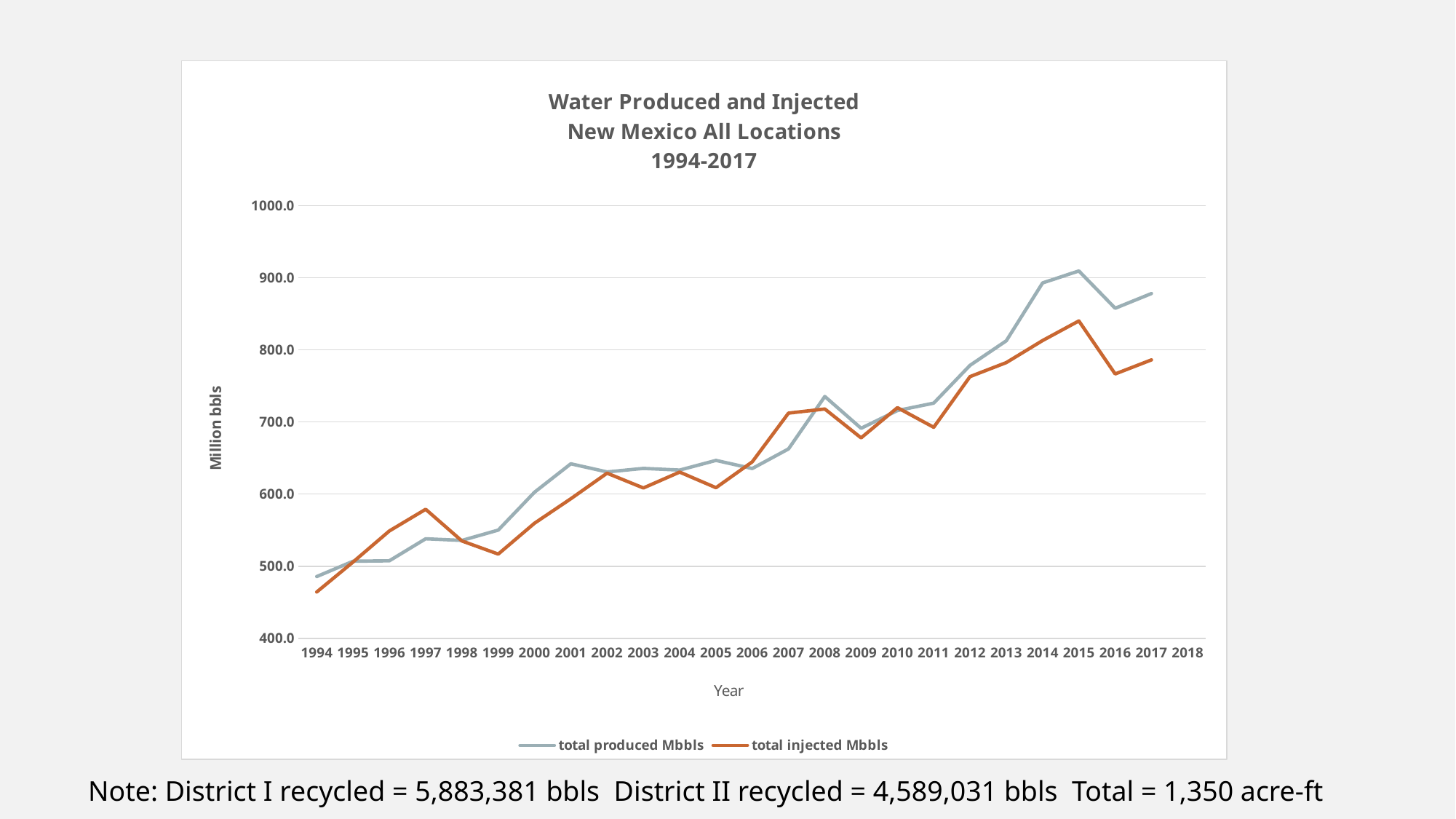
What is the label on the vertical axis? Million bbls In which year does the total produced Mbbls line reach its highest value? 2015 What type of chart is shown on the slide? Line chart Is the total produced Mbbls value for 2015 greater or less than 900.0? greater In 2017, which series has the higher value: total produced Mbbls or total injected Mbbls? total produced Mbbls Over the period 1994 to 2017, do the total produced Mbbls values generally rise or fall? Rise What are the two series named in the legend? total produced Mbbls and total injected Mbbls In which year does the total injected Mbbls line reach its highest value? 2015 Is the total injected Mbbls value for 2009 greater or less than 700.0? less In which year is the total injected Mbbls value lowest? 1994 Is the total injected Mbbls value for 1994 greater or less than 500.0? less How many series does the legend list? 2